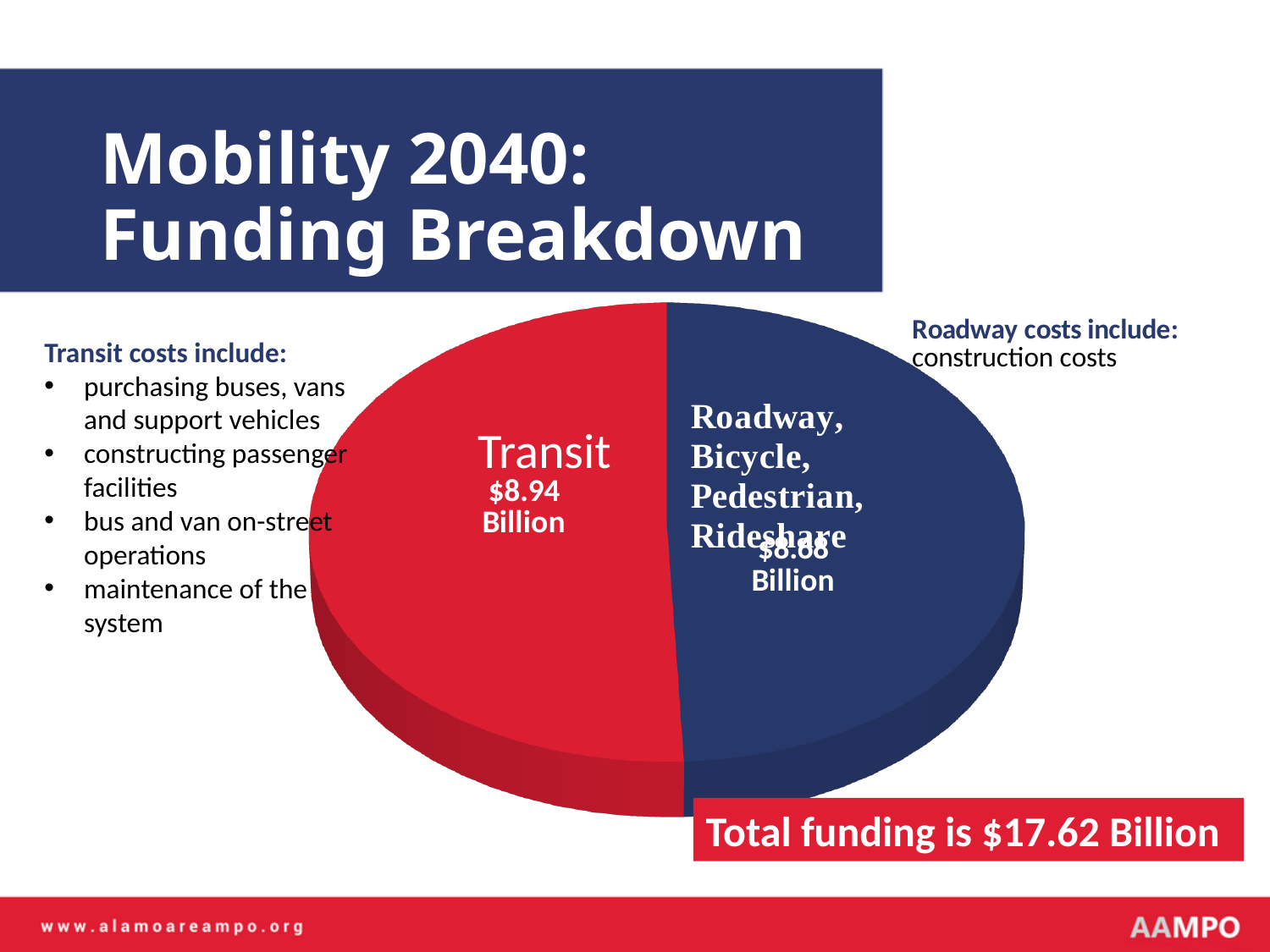
Is the funding for Transit larger or smaller than the funding for Roadway, Bicycle, Pedestrian, Rideshare? larger What is the title of the slide containing the pie chart? Mobility 2040: Funding Breakdown What is the difference between the Transit funding and the Roadway, Bicycle, Pedestrian, Rideshare funding? $0.26 Billion What colour is the Transit slice of the pie chart? red What is the funding amount for Transit in the pie chart? $8.94 Billion Which slice of the pie chart has the larger funding amount? Transit How many slices does the pie chart have? 2 What is the funding amount for Roadway, Bicycle, Pedestrian, Rideshare in the pie chart? $8.68 Billion Which slice of the pie chart has the smaller funding amount? Roadway, Bicycle, Pedestrian, Rideshare What is the total funding shown on the slide? $17.62 Billion What kind of chart is shown on the slide? pie chart